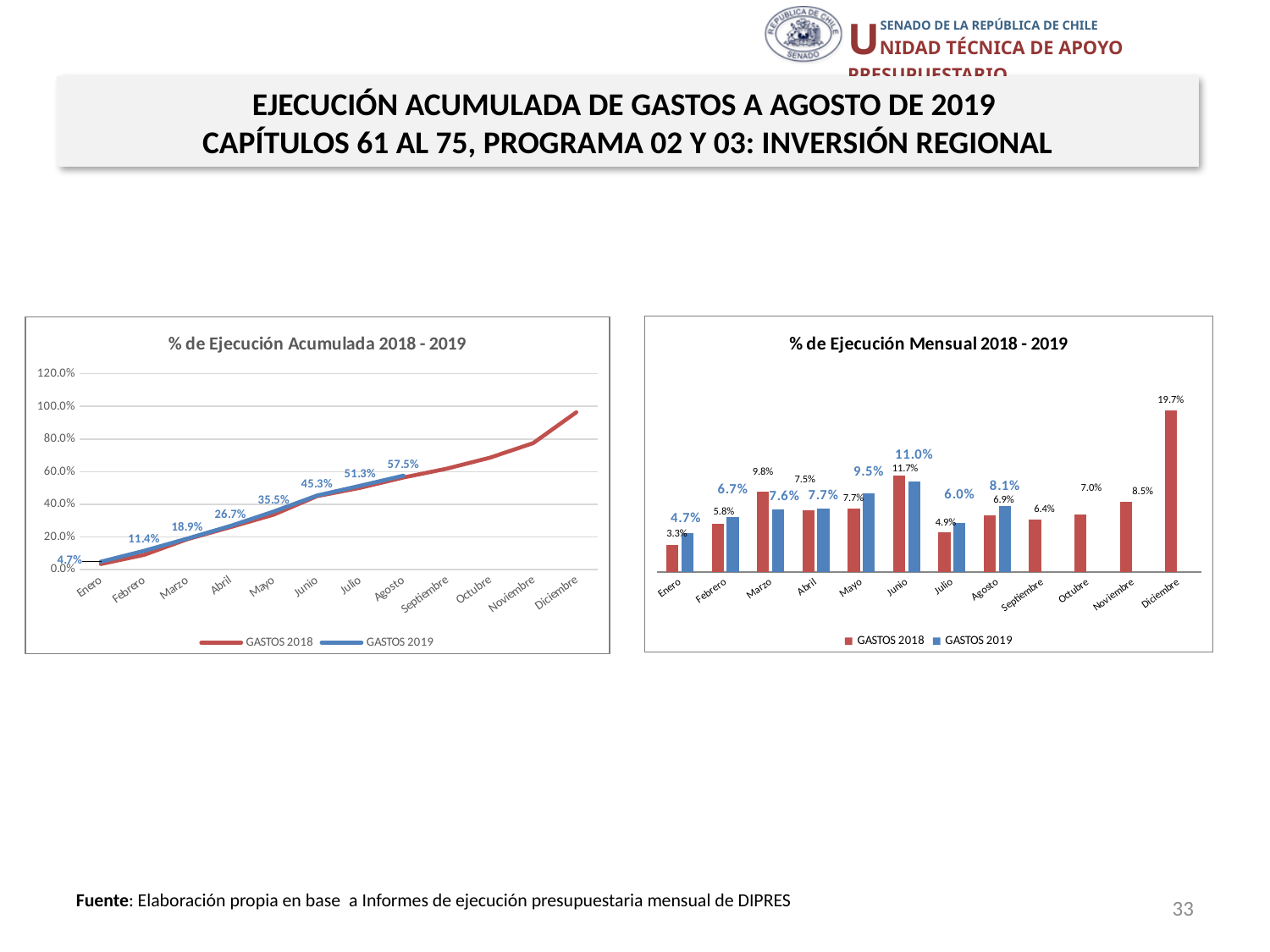
In the right chart '% de Ejecución Mensual 2018 - 2019', which is larger for Marzo: GASTOS 2018 or GASTOS 2019? GASTOS 2018 What kind of chart is the right chart, '% de Ejecución Mensual 2018 - 2019'? Bar chart In the right chart '% de Ejecución Mensual 2018 - 2019', which month has the highest GASTOS 2018 value? Diciembre What kind of chart is the left chart, '% de Ejecución Acumulada 2018 - 2019'? Line chart In the right chart '% de Ejecución Mensual 2018 - 2019', what is the GASTOS 2019 value for Junio? 11.0% In the left chart '% de Ejecución Acumulada 2018 - 2019', what is the value for GASTOS 2019 in Agosto? 57.5% How many series does the legend of the left chart '% de Ejecución Acumulada 2018 - 2019' list? 2 In the left chart '% de Ejecución Acumulada 2018 - 2019', is the value for GASTOS 2018 in Diciembre greater or less than 80.0%? greater In the right chart '% de Ejecución Mensual 2018 - 2019', which month has the lowest GASTOS 2018 value? Enero In the left chart '% de Ejecución Acumulada 2018 - 2019', what is the value for GASTOS 2019 in Abril? 26.7% In the right chart '% de Ejecución Mensual 2018 - 2019', what is the difference between the GASTOS 2018 and GASTOS 2019 values for Junio? 0.7 percentage points In the left chart '% de Ejecución Acumulada 2018 - 2019', does the GASTOS 2019 line rise or fall from Enero to Agosto? Rises